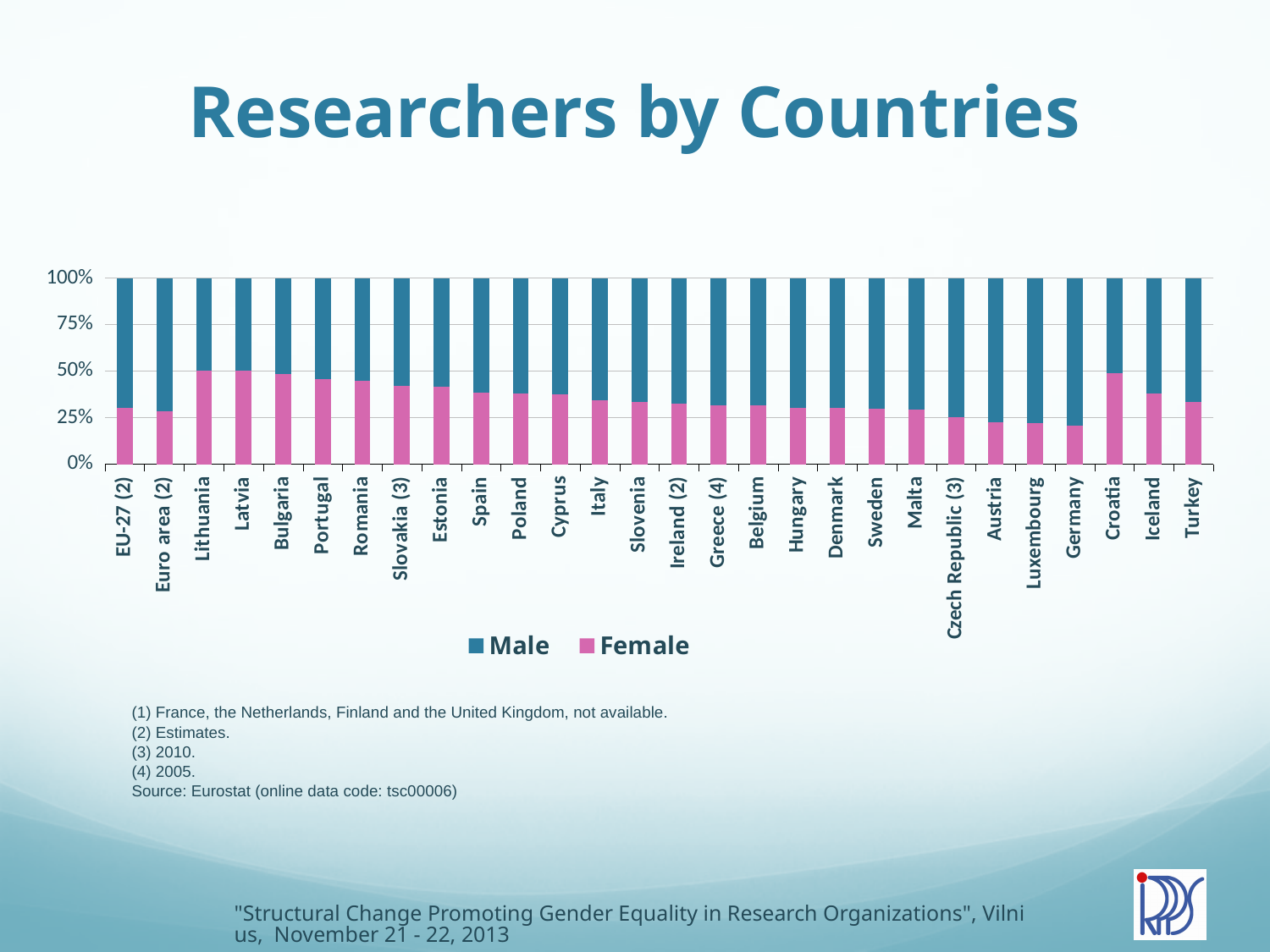
How many countries or regions are shown along the x axis? 28 Is the Female share for Portugal greater or less than 25%? greater What are the two series named in the legend? Male and Female How many series does the legend list? 2 Is the Male share for Germany greater or less than 75%? greater What is the title of the chart? Researchers by Countries What kind of chart is shown on the slide? Stacked bar chart Is the Female share for Germany greater or less than 25%? less Which has the larger Female share, Spain or Sweden? Spain Which has the larger Female share, Portugal or Italy? Portugal What is the total of the stacked bar for Spain (Male plus Female)? 100%